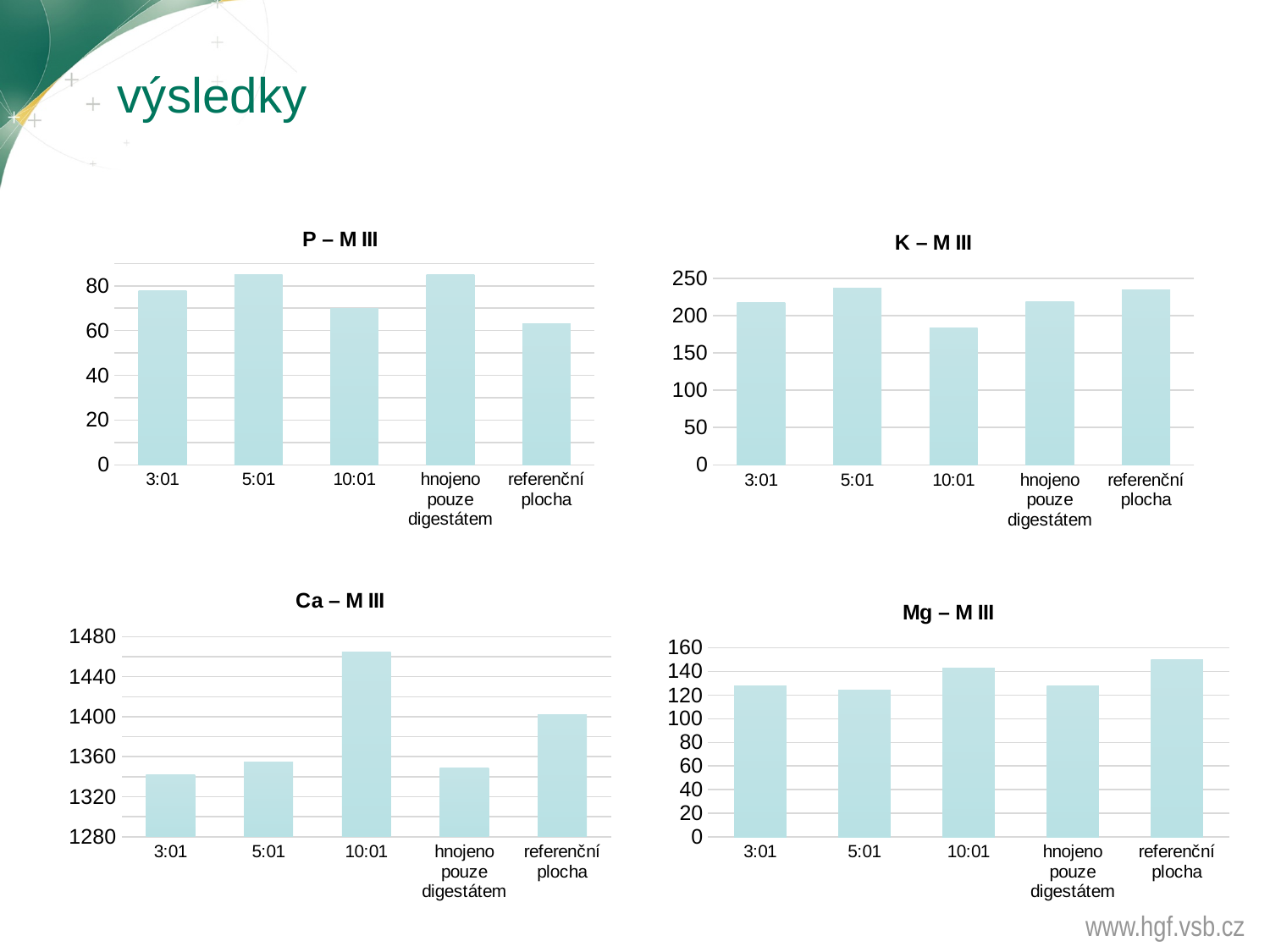
In the K – M III chart, is the value for 3:01 greater or less than 200? greater In the P – M III chart, is the value for 10:01 greater or less than 60? greater In the K – M III chart, which category has the lowest value? 10:01 What type of chart is the Ca – M III chart? bar chart In the Ca – M III chart, which category has the highest value? 10:01 In the P – M III chart, which category has the lowest value? referenční plocha In the Mg – M III chart, which is larger, the value for 10:01 or the value for 5:01? 10:01 How many categories are shown on the x axis of the Mg – M III chart? 5 In the P – M III chart, is the value for referenční plocha greater or less than 80? less In the Mg – M III chart, which category has the highest value? referenční plocha